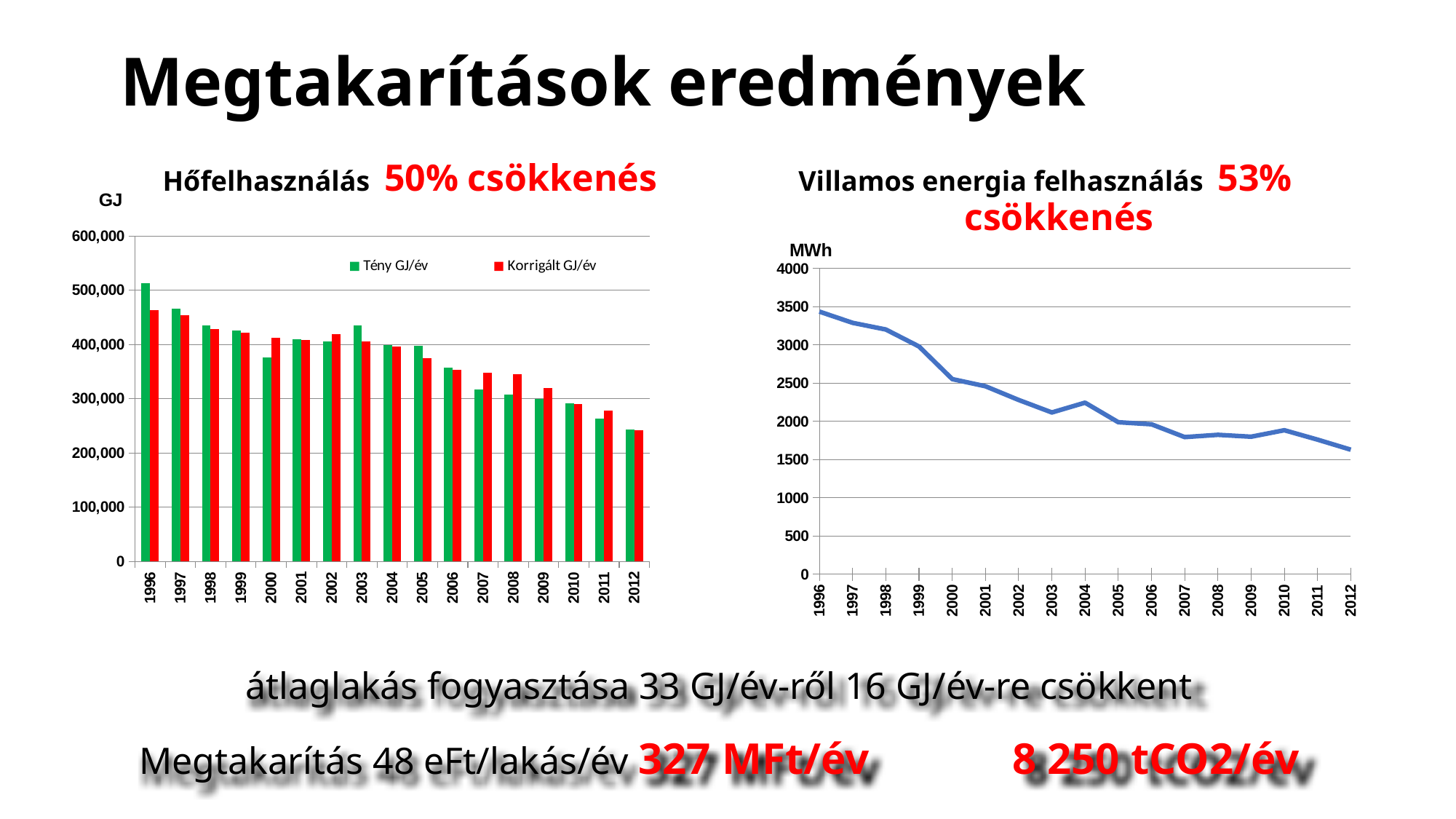
What kind of chart is the Hőfelhasználás chart on the left? bar chart How many years are shown on the x axis of the Villamos energia felhasználás chart? 17 In the Hőfelhasználás chart, is the Korrigált GJ/év value for 2012 greater or less than 300,000? less In the Hőfelhasználás chart, for the year 2000, which series has the larger value: Tény GJ/év or Korrigált GJ/év? Korrigált GJ/év In the Villamos energia felhasználás chart, is the value for 2012 greater or less than 2000? less In the Hőfelhasználás chart, which year has the lowest Tény GJ/év value? 2012 In the Hőfelhasználás chart, which year has the highest Tény GJ/év value? 1996 In the Villamos energia felhasználás chart, is the value for 1996 greater or less than 3000? greater What kind of chart is the Villamos energia felhasználás chart on the right? line chart How many series does the legend of the Hőfelhasználás chart list? 2 In the Villamos energia felhasználás chart, do the values generally rise or fall from 1996 to 2012? fall